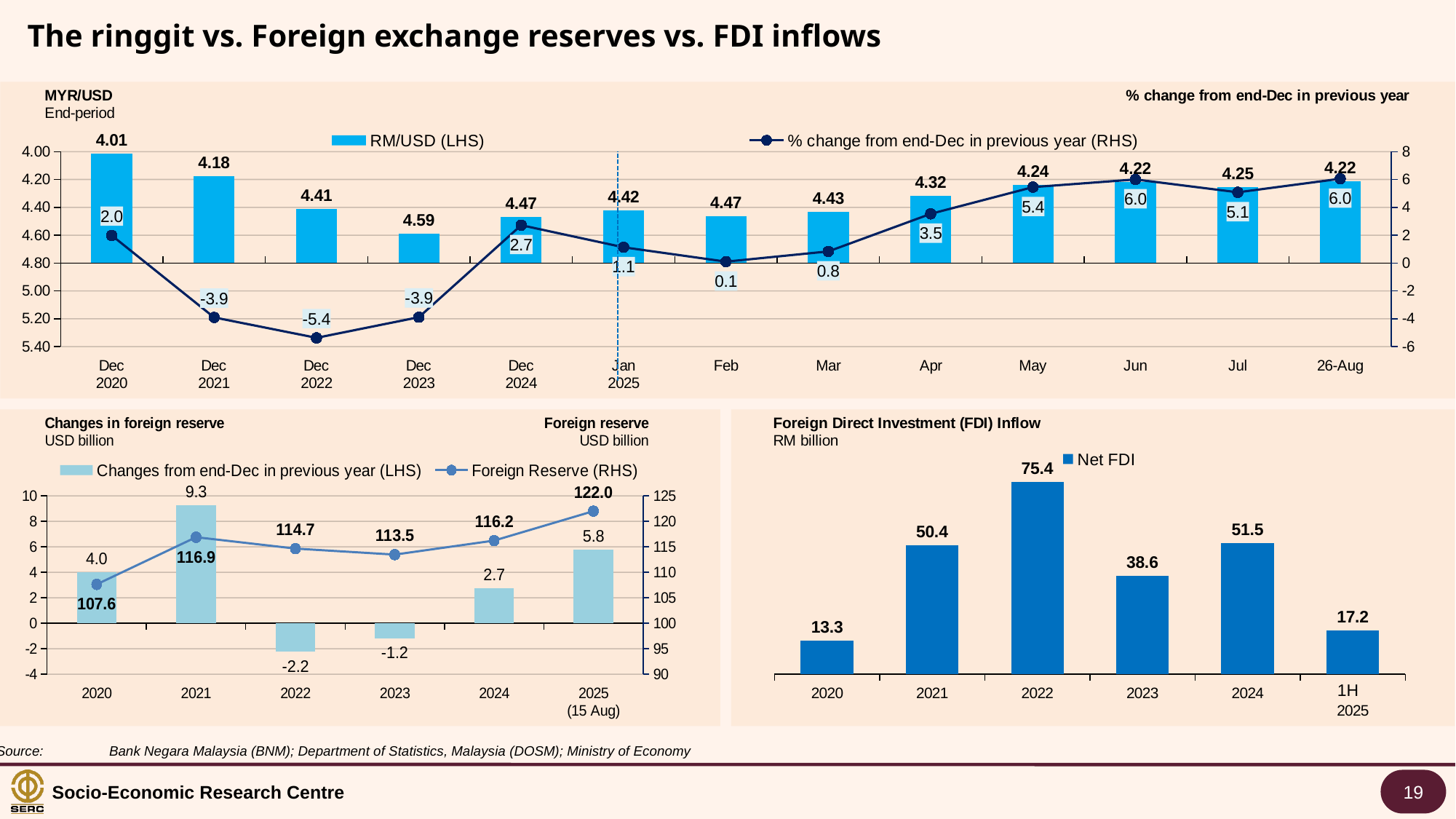
What kind of chart is the Foreign Direct Investment (FDI) Inflow chart? Bar chart In the MYR/USD chart, what is the % change from end-Dec in previous year for Dec 2022? -5.4 In the Changes in foreign reserve chart, which year has the highest change from end-Dec in previous year? 2021 In the Changes in foreign reserve chart, what is the difference between the Foreign Reserve values for 2021 and 2020? 9.3 In the MYR/USD chart, what is the RM/USD value for Dec 2023? 4.59 In the Foreign Direct Investment (FDI) Inflow chart, is Net FDI larger in 2021 or 2024? 2024 In the MYR/USD chart, how many periods are shown on the x axis? 13 In the Foreign Direct Investment (FDI) Inflow chart, which year has the highest Net FDI? 2022 In the Changes in foreign reserve chart, what is the Foreign Reserve value for 2025 (15 Aug)? 122.0 In the Foreign Direct Investment (FDI) Inflow chart, what is the difference between Net FDI in 2022 and 2023? 36.8 In the Foreign Direct Investment (FDI) Inflow chart, which period has the lowest Net FDI? 2020 In the MYR/USD chart, how many series does the legend list? 2